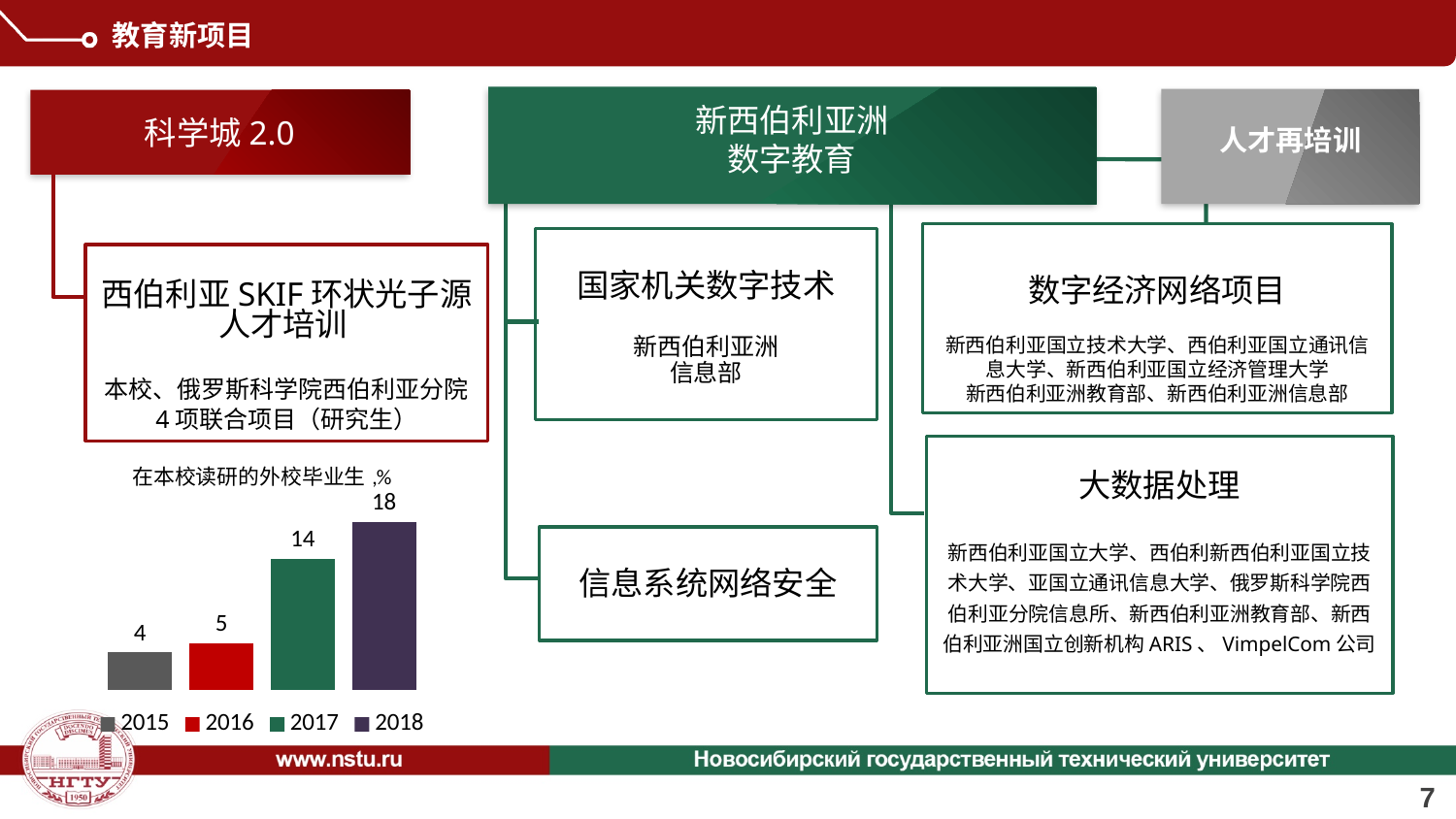
What is the difference between the values for 2018 and 2017 in the bar chart? 4 What is the value for 2017 in the bar chart? 14 What is the value for 2015 in the bar chart? 4 What is the difference between the values for 2017 and 2016 in the bar chart? 9 Do the values in the bar chart rise or fall from 2015 to 2018? rise What is the value for 2016 in the bar chart? 5 How many bars are shown in the bar chart? 4 Which is larger in the bar chart, the value for 2016 or the value for 2017? 2017 How many entries does the legend of the bar chart list? 4 Which year has the lowest value in the bar chart? 2015 What is the value for 2018 in the bar chart? 18 Which year has the highest value in the bar chart? 2018